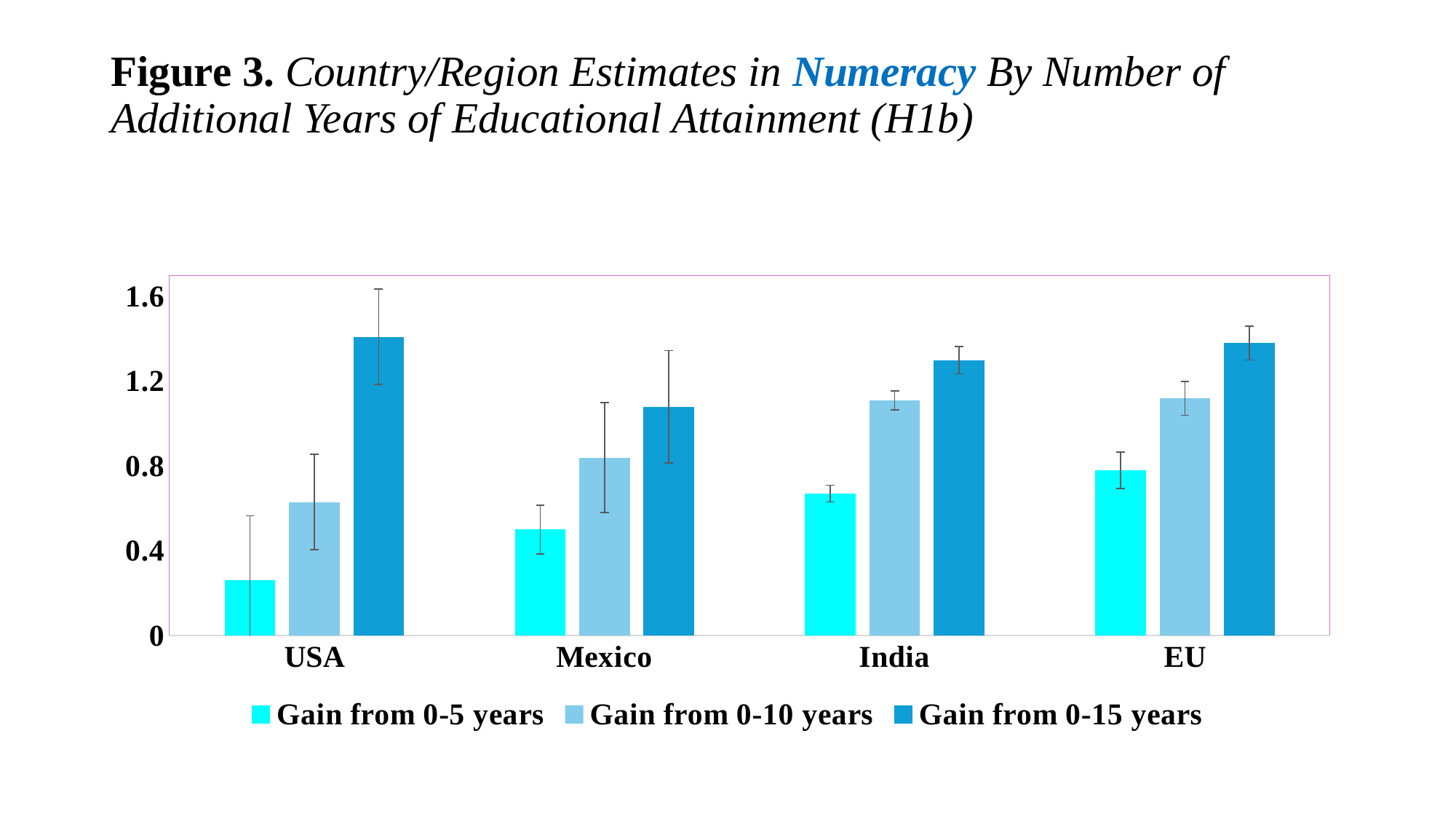
Which country/region has the lowest value in the 'Gain from 0-5 years' series? USA Is the value for USA in the 'Gain from 0-5 years' series greater or less than 0.4? less Which series is shown in the darkest blue colour in the legend? Gain from 0-15 years Is the value for USA in the 'Gain from 0-15 years' series greater or less than 1.2? greater Within each country/region, do the values rise or fall from 'Gain from 0-5 years' to 'Gain from 0-15 years'? rise Is the value for India in the 'Gain from 0-10 years' series greater or less than 0.8? greater How many countries/regions are shown on the x axis? 4 Which country/region has the lowest value in the 'Gain from 0-15 years' series? Mexico Which is larger: the 'Gain from 0-10 years' value for India or for Mexico? India What kind of chart is shown on the slide? bar chart How many series does the legend list? 3